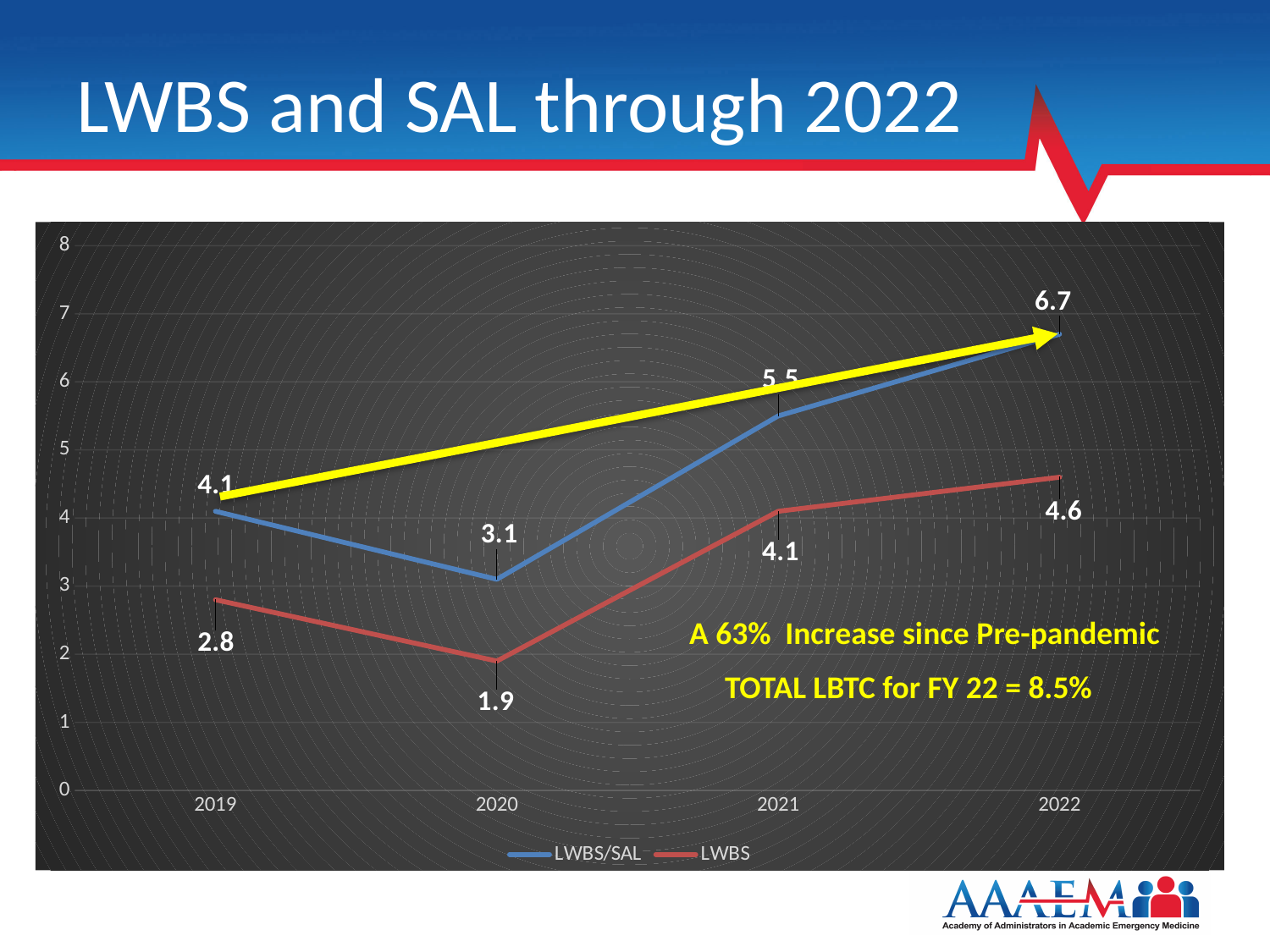
How many years are shown on the x axis? 4 What is the LWBS value for 2020? 1.9 What is the LWBS value for 2019? 2.8 What type of chart is shown on the slide? line chart Which is larger, the LWBS/SAL value in 2021 or the LWBS value in 2021? LWBS/SAL What is the difference between the LWBS/SAL value and the LWBS value in 2022? 2.1 In which year is the LWBS value highest? 2022 How many series does the legend list? 2 In which year is the LWBS/SAL value lowest? 2020 What is the title of the slide? LWBS and SAL through 2022 What is the LWBS/SAL value for 2022? 6.7 Does the LWBS/SAL series rise or fall from 2020 to 2022? rise